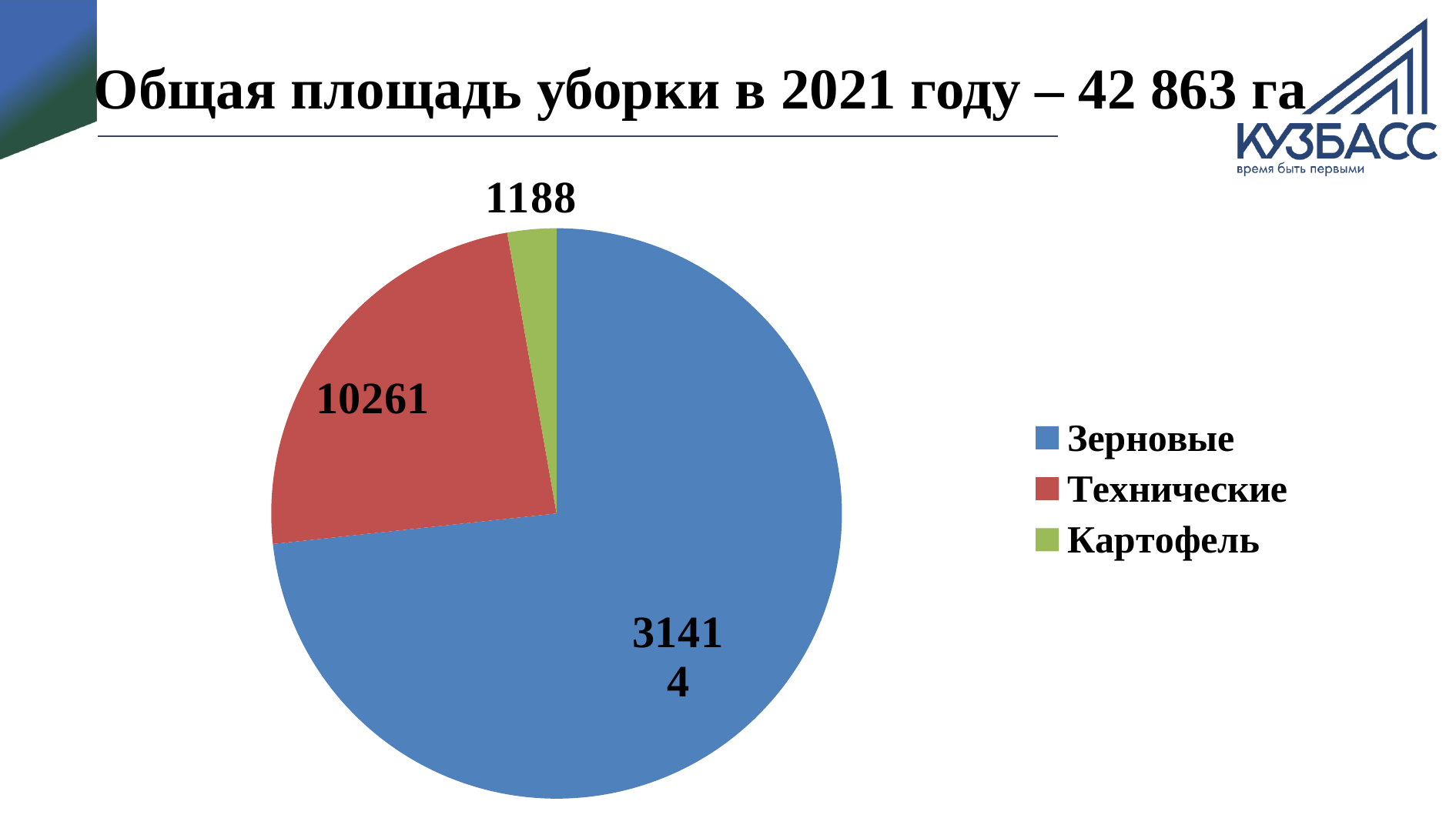
What is the value for Зерновые? 31414 What colour is the slice for Картофель? green Which is larger, the value for Технические or the value for Картофель? Технические What is the value for Технические? 10261 What is the difference between the values for Технические and Картофель? 9073 Which category has the smallest slice of the pie? Картофель What is the total of all three slices of the pie? 42863 What is the difference between the values for Зерновые and Технические? 21153 What kind of chart is shown on the slide? pie chart How many categories does the legend list? 3 What is the value for Картофель? 1188 Which category has the largest slice of the pie? Зерновые